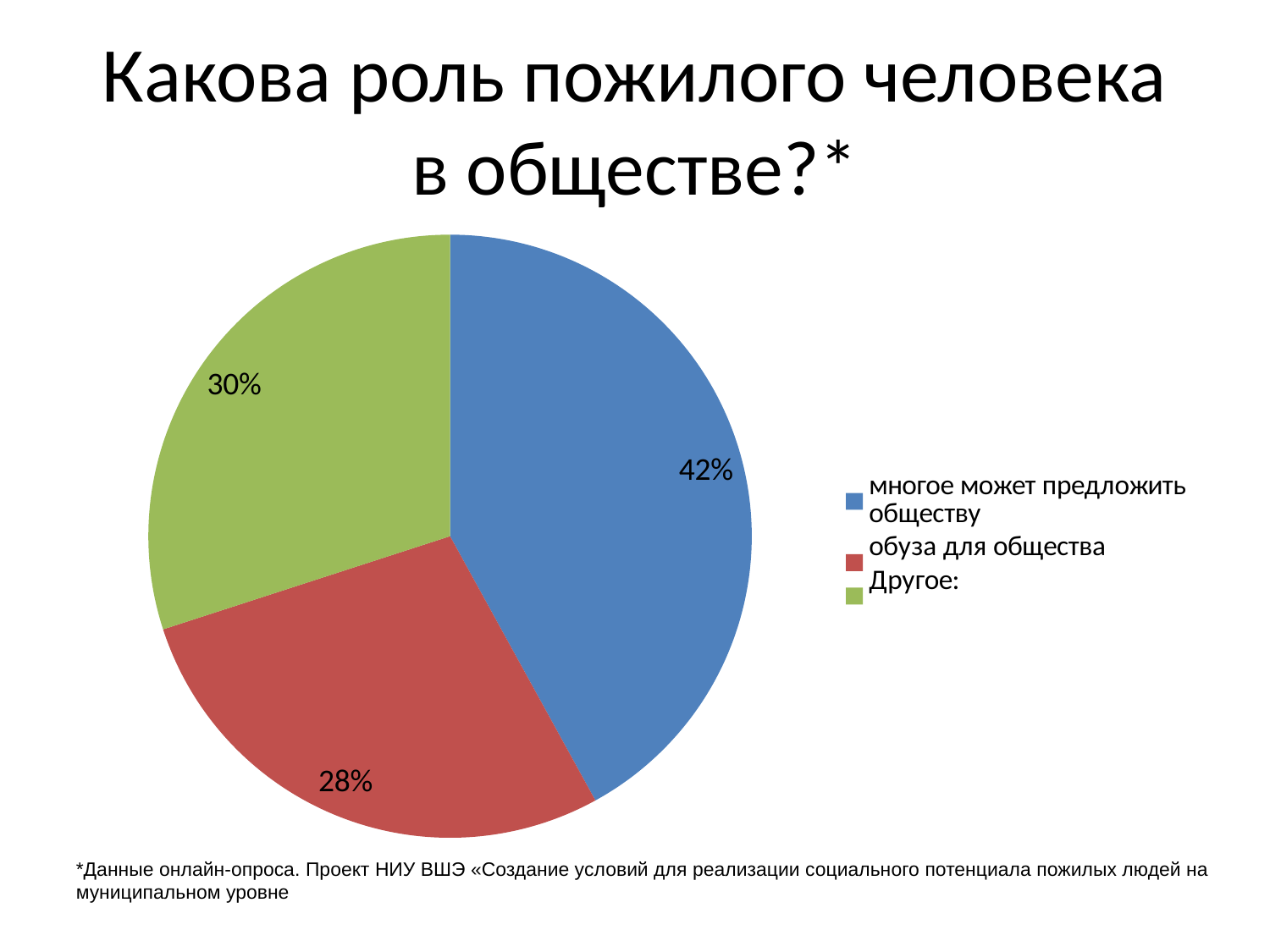
How many slices does the pie chart have? 3 What is the difference in percentage points between "Другое:" and "обуза для общества"? 2 Which category has the largest slice of the pie? многое может предложить обществу Which is larger: the share for "многое может предложить обществу" or the share for "Другое:"? многое может предложить обществу What is the difference in percentage points between "многое может предложить обществу" and "обуза для общества"? 14 How many entries does the legend list? 3 What share of the pie does "обуза для общества" have? 28% What colour is the slice for "обуза для общества"? red What type of chart is shown on the slide? pie chart What share of the pie does "многое может предложить обществу" have? 42% What share of the pie does "Другое:" have? 30% Which category has the smallest slice of the pie? обуза для общества